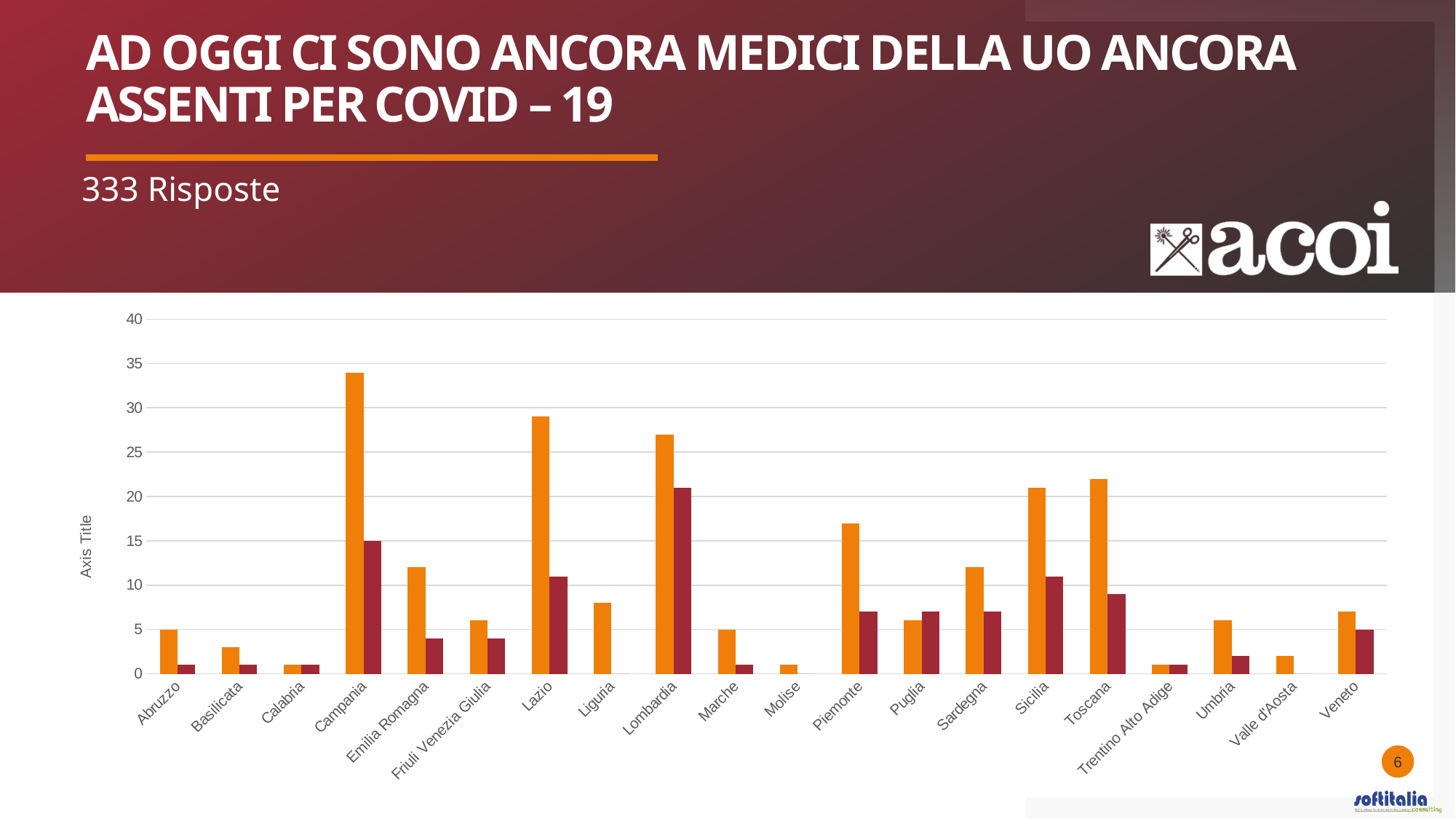
Which region has the tallest dark red bar in the chart? Lombardia What kind of chart is shown on the slide? bar chart Is the orange bar for Lombardia greater or less than 25? greater Is the orange bar for Liguria greater or less than 10? less What is the label shown on the vertical axis of the chart? Axis Title Is the orange bar for Campania greater or less than 30? greater How many regions (categories) are shown on the x axis of the chart? 20 Which region has the tallest orange bar in the chart? Campania Which is larger, the dark red bar for Lombardia or the dark red bar for Campania? Lombardia Which is larger, the orange bar for Campania or the orange bar for Lazio? Campania